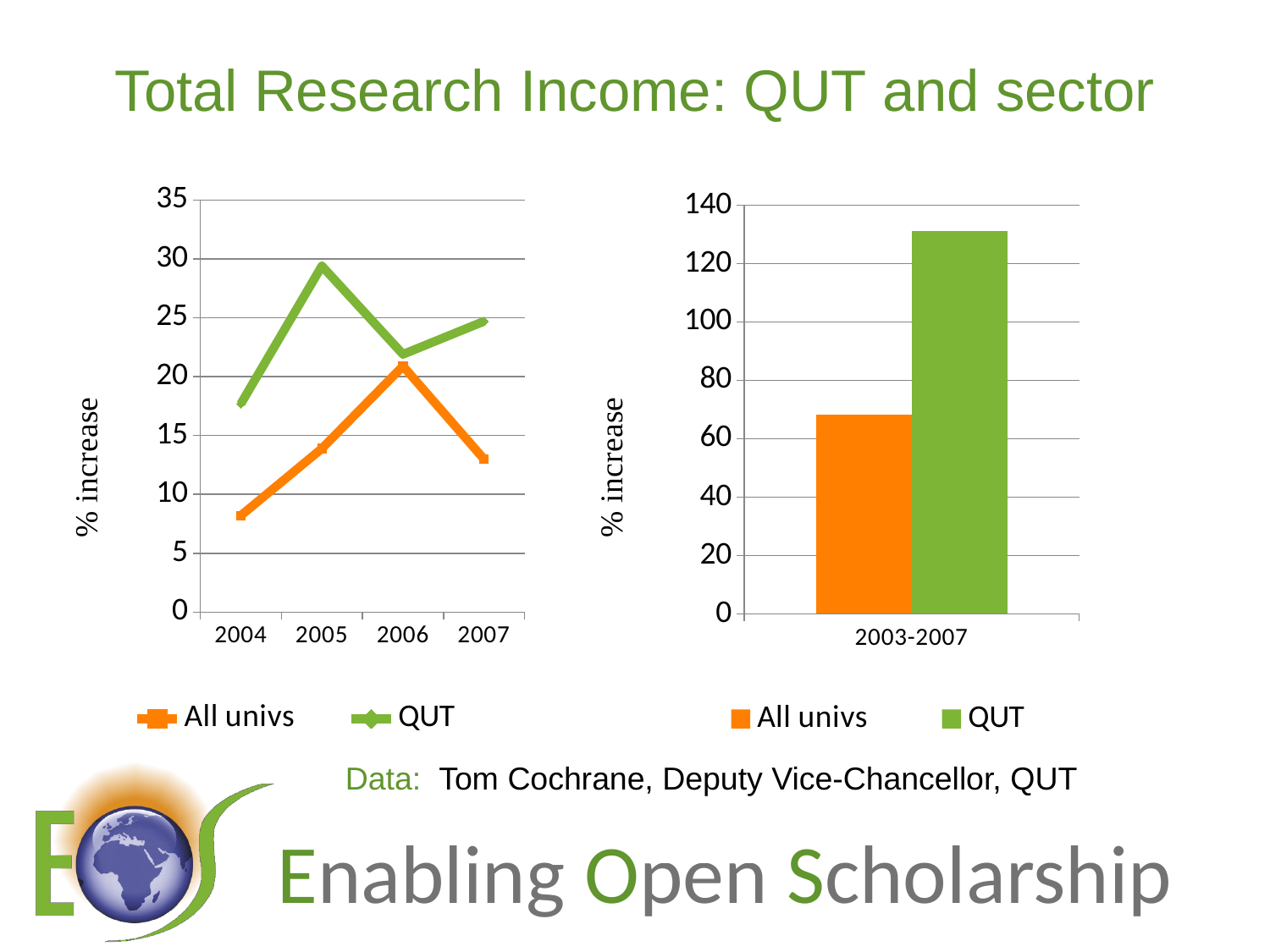
In the left chart, in which year is the All univs value lowest? 2004 In the right chart, which is larger for 2003-2007, All univs or QUT? QUT In the right chart, is the value for All univs greater or less than 80? less In the left chart, does the All univs line rise or fall from 2004 to 2006? rise What kind of chart is the left chart on the slide? line chart In the left chart, how many series does the legend list? 2 In the left chart, is the QUT value for 2005 greater or less than 25? greater What is the category label on the x axis of the right chart? 2003-2007 In the left chart, how many years are shown on the x axis? 4 What kind of chart is the right chart on the slide? bar chart In the left chart, in which year is the QUT value highest? 2005 In the right chart, is the value for QUT greater or less than 120? greater